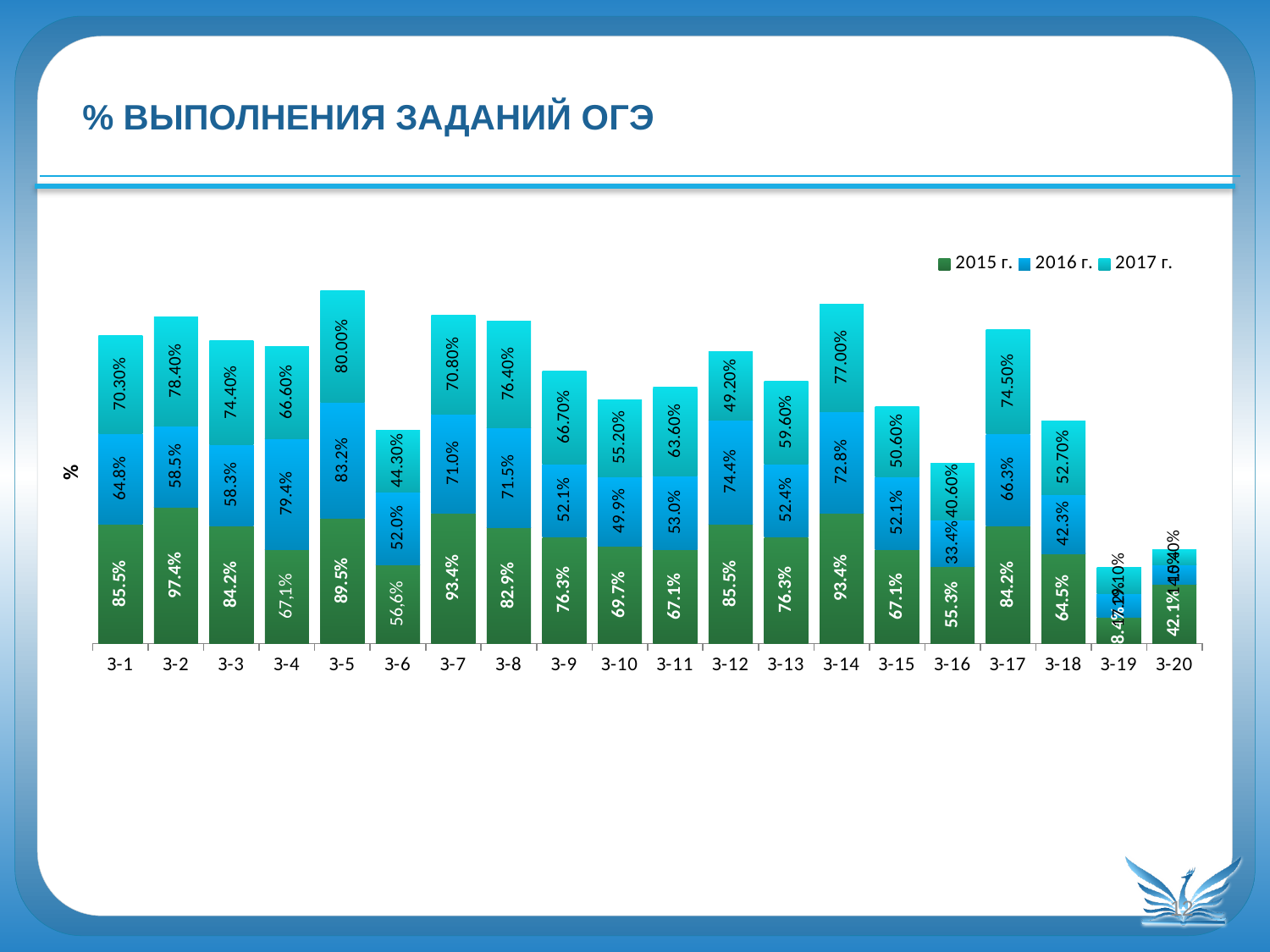
How many series does the legend list? 3 What is the 2015 г. value for category 3-2? 97.4% Which category has the highest 2016 г. value? 3-5 What is the 2017 г. value for category 3-5? 80.00% How many categories are shown on the x axis? 20 Which category has the highest 2015 г. value? 3-2 What is the 2017 г. value for category 3-12? 49.20% Which has the larger 2015 г. value, 3-7 or 3-8? 3-7 What is the difference between the 2015 г. values for 3-2 and 3-1? 11.9% What kind of chart is shown on the slide? Stacked bar chart What is the 2016 г. value for category 3-16? 33.4% What is the title of the slide? % ВЫПОЛНЕНИЯ ЗАДАНИЙ ОГЭ